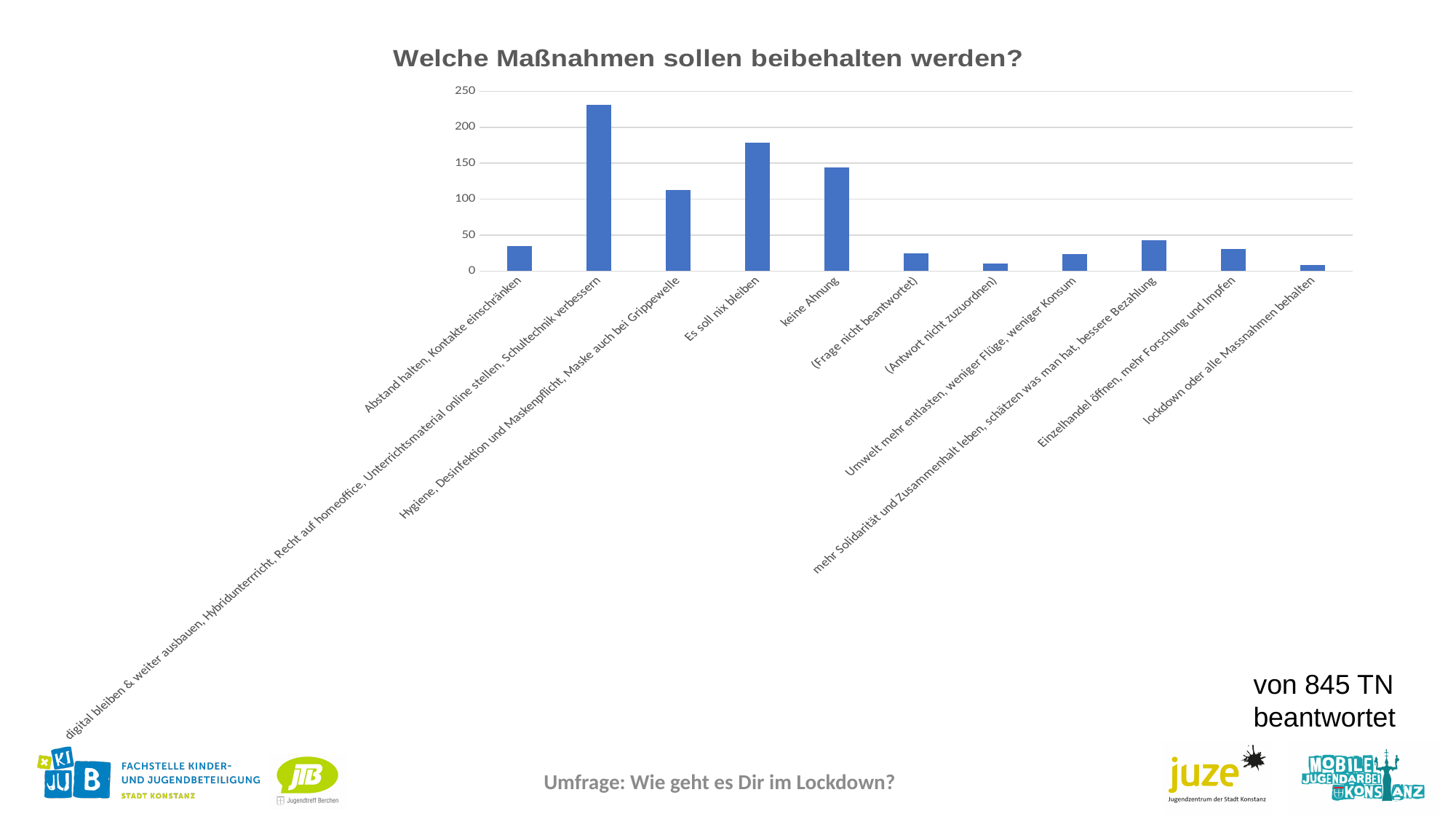
Is the value for 'Hygiene, Desinfektion und Maskenpflicht, Maske auch bei Grippewelle' greater or less than 100? greater Is the value for 'keine Ahnung' greater or less than 150? less How many categories (bars) does the chart show? 11 Which is larger: the value for 'Es soll nix bleiben' or the value for 'keine Ahnung'? Es soll nix bleiben Which category has the lowest value? lockdown oder alle Massnahmen behalten Which is larger: the value for 'mehr Solidarität und Zusammenhalt leben, schätzen was man hat, bessere Bezahlung' or the value for '(Antwort nicht zuzuordnen)'? mehr Solidarität und Zusammenhalt leben, schätzen was man hat, bessere Bezahlung What is the title of the chart? Welche Maßnahmen sollen beibehalten werden? Is the value for 'Abstand halten, Kontakte einschränken' greater or less than 50? less What type of chart is shown on the slide? bar chart Which category has the highest value? digital bleiben & weiter ausbauen, Hybridunterrricht, Recht auf homeoffice, Unterrichtsmaterial online stellen, Schultechnik verbessern What is the highest value shown on the vertical axis? 250